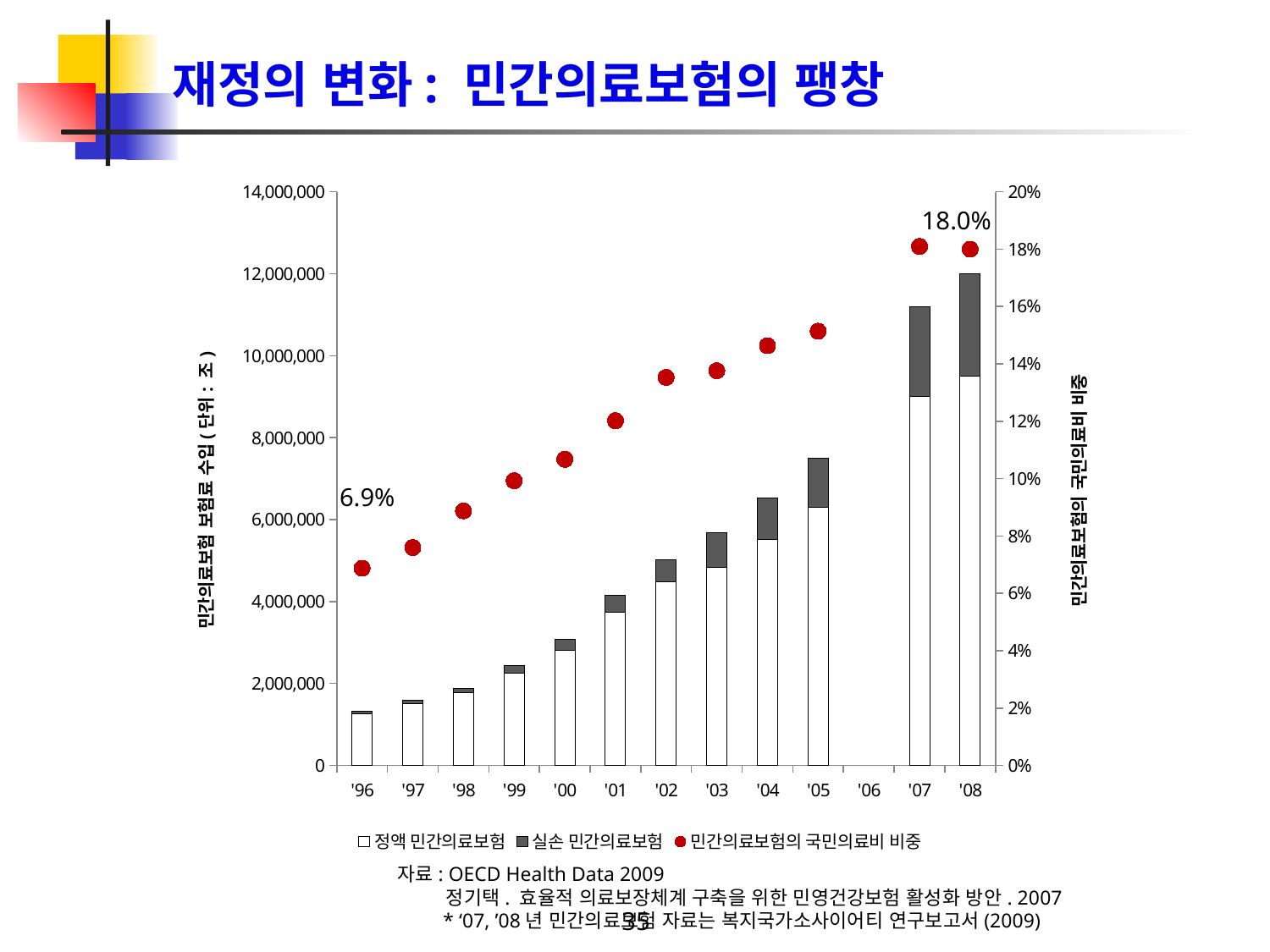
Does 민간의료보험의 국민의료비 비중 rise or fall from '96 to '08? rise Which year has the shortest stacked bar for 민간의료보험 보험료 수입? '96 How many series does the legend list? 3 How many year categories are shown on the x axis? 13 Is the total stacked bar for '08 greater or less than 10,000,000? greater What type of chart is used to show 정액 민간의료보험 and 실손 민간의료보험? stacked bar chart Which year has the tallest stacked bar for 민간의료보험 보험료 수입? '08 Is the value of 민간의료보험의 국민의료비 비중 for '01 greater or less than 10%? greater What is the maximum value shown on the right-hand (percentage) axis? 20% What is the value of 민간의료보험의 국민의료비 비중 for '96? 6.9%